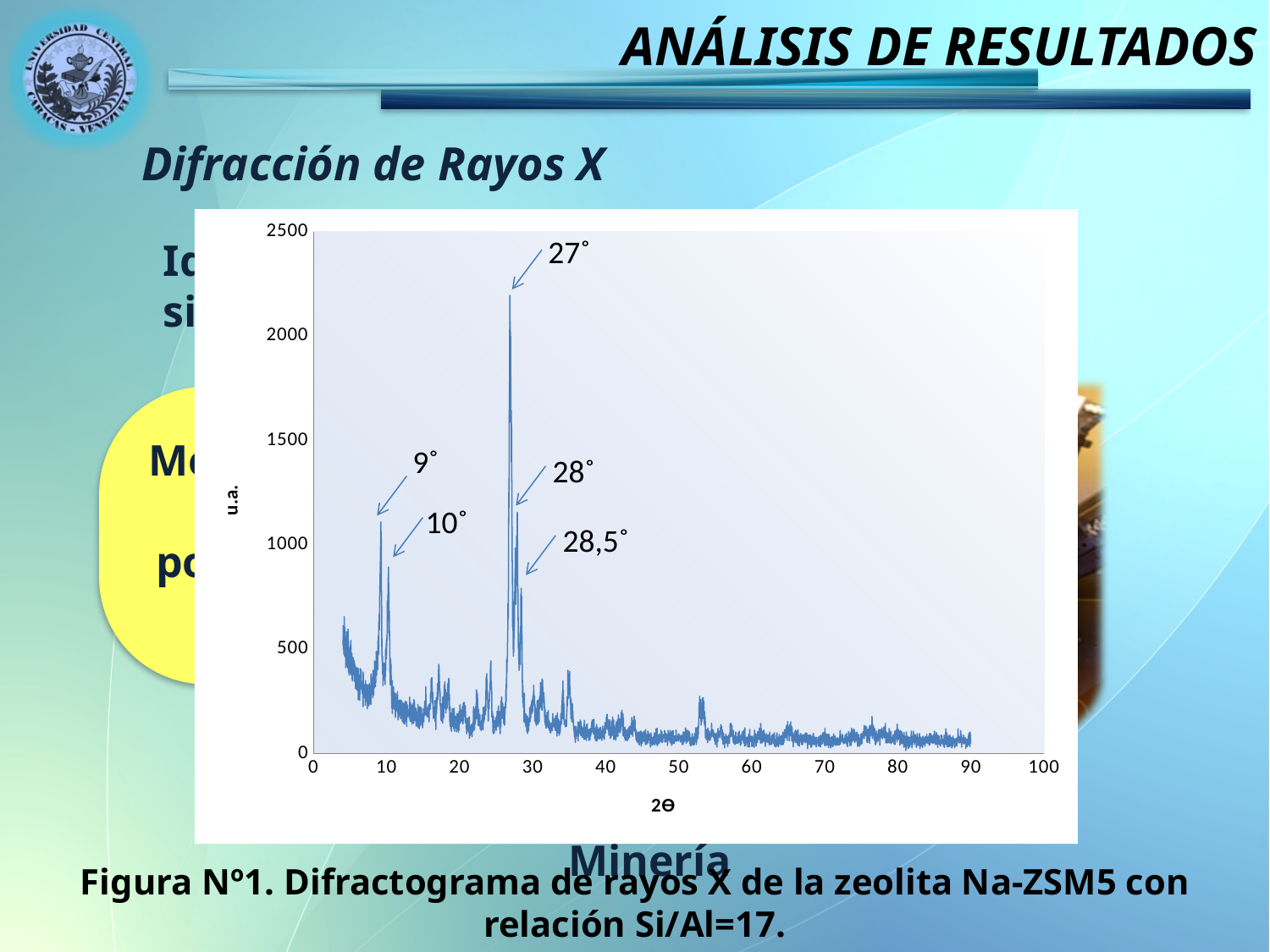
Which peak is higher, the one at 9˚ or the one at 10˚? 9˚ Which peak is higher, the one at 27˚ or the one at 9˚? 27˚ What is the maximum value shown on the y axis of the chart? 2500 Is the intensity of the peak at 9˚ greater or less than 500? greater Is the intensity of the peak at 27˚ greater or less than 2000? greater How many peaks are annotated with angle labels on the chart? 5 Is the intensity of the peak at 10˚ greater or less than 1000? less At which annotated angle does the chart show its highest peak? 27˚ What is the label of the y axis of the chart? u.a. What is the label of the x axis of the chart? 2Θ What kind of chart is shown on the slide? line chart